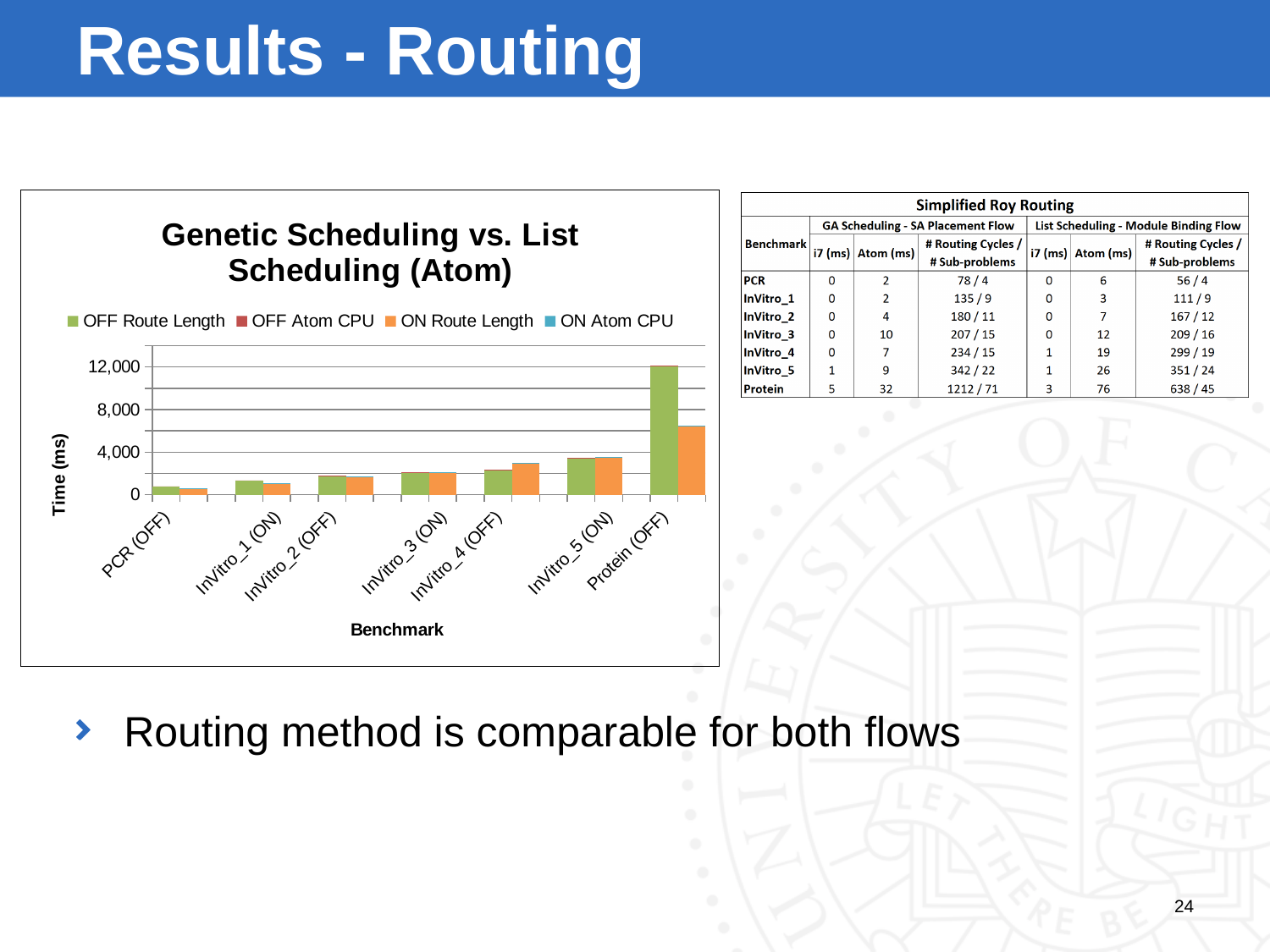
Is the ON Route Length value for Protein (OFF) greater or less than 4,000? greater Do the Route Length values generally rise or fall moving from PCR (OFF) to Protein (OFF) along the x axis? rise For Protein (OFF), which is larger: the OFF Route Length or the ON Route Length? OFF Route Length How many series does the chart's legend list? 4 Is the OFF Route Length value for PCR (OFF) greater or less than 4,000? less Is the OFF Route Length value for Protein (OFF) greater or less than 8,000? greater How many benchmark categories are shown on the x axis of the chart? 7 For InVitro_4 (OFF), which is larger: the OFF Route Length or the ON Route Length? ON Route Length Which benchmark has the lowest OFF Route Length value? PCR (OFF) What kind of chart is shown on the slide? bar chart Which benchmark has the highest OFF Route Length value? Protein (OFF) What is the label of the chart's y axis? Time (ms)